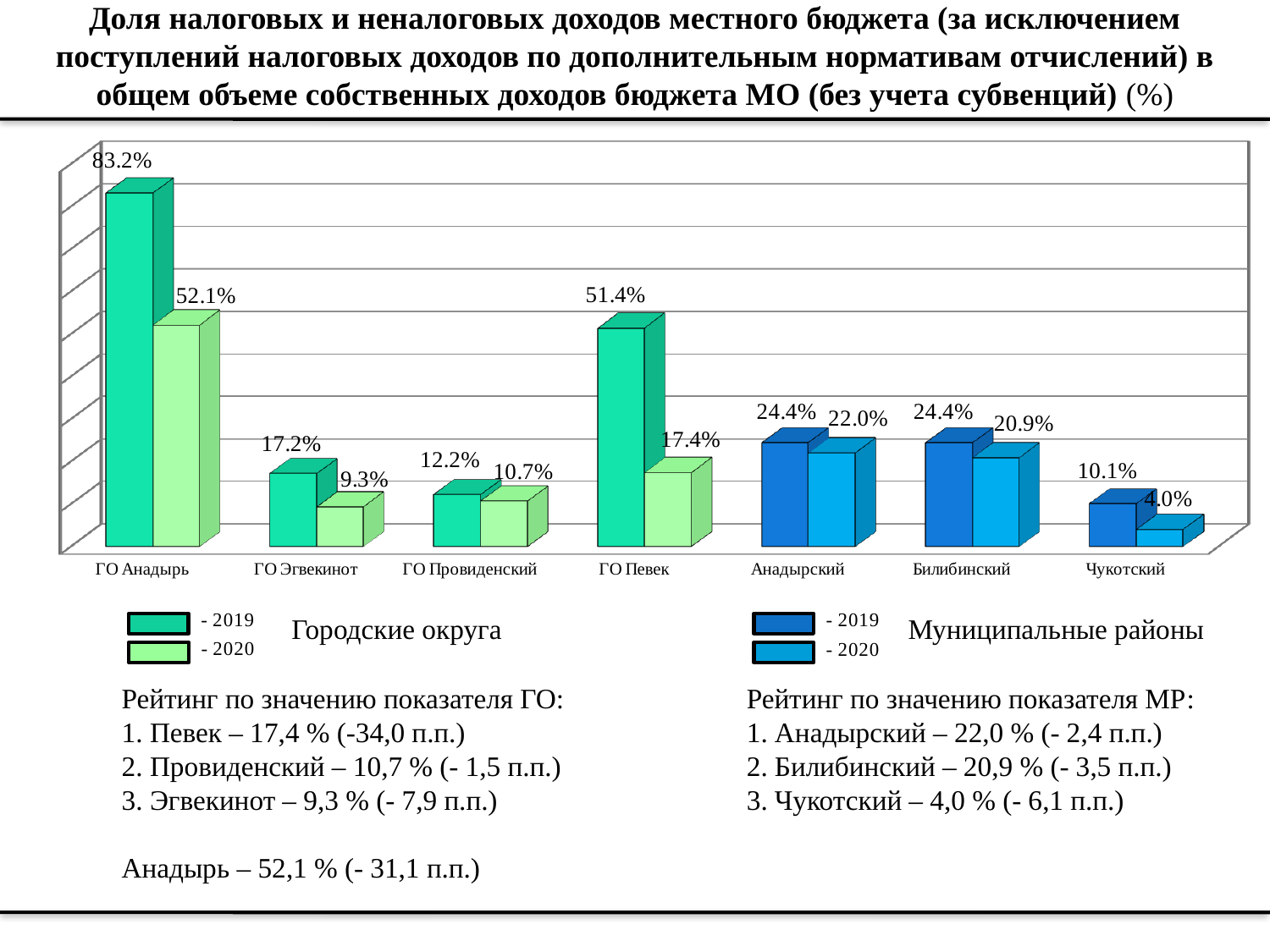
Which category has the highest 2019 value? ГО Анадырь What is the 2020 value for ГО Певек? 17.4% What kind of chart is shown on the slide? Bar chart Which is larger: the 2019 value for ГО Певек or the 2019 value for Анадырский? ГО Певек Which two years does the chart legend list? 2019 and 2020 What is the 2019 value for ГО Анадырь? 83.2% What is the difference between the 2019 and 2020 values for ГО Певек? 34.0 percentage points What is the difference between the 2019 and 2020 values for ГО Анадырь? 31.1 percentage points What is the 2019 value for Чукотский? 10.1% Which category has the lowest 2020 value? Чукотский How many categories are shown on the x axis of the chart? 7 What is the 2020 value for Билибинский? 20.9%